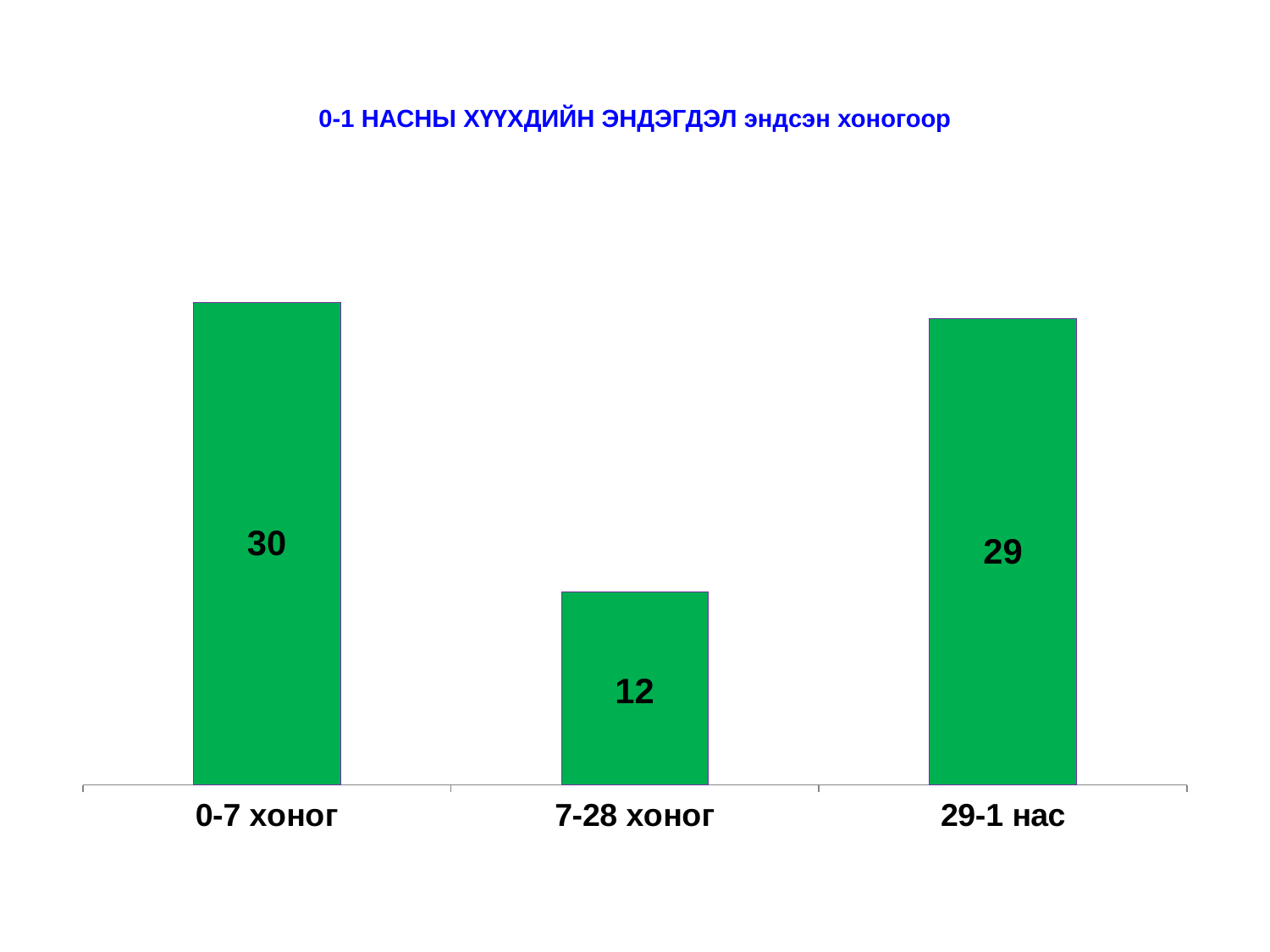
How many categories are shown on the x axis? 3 Which category has the highest value? 0-7 хоног What colour are the bars in the chart? green What kind of chart is shown on the slide? bar chart Which category has the lowest value? 7-28 хоног What is the value for 29-1 нас? 29 What is the value for 7-28 хоног? 12 What is the total of the three values shown in the chart? 71 Which is larger, the value for 7-28 хоног or the value for 29-1 нас? 29-1 нас What is the difference between the values for 0-7 хоног and 7-28 хоног? 18 What is the value for 0-7 хоног? 30 What is the difference between the values for 29-1 нас and 7-28 хоног? 17